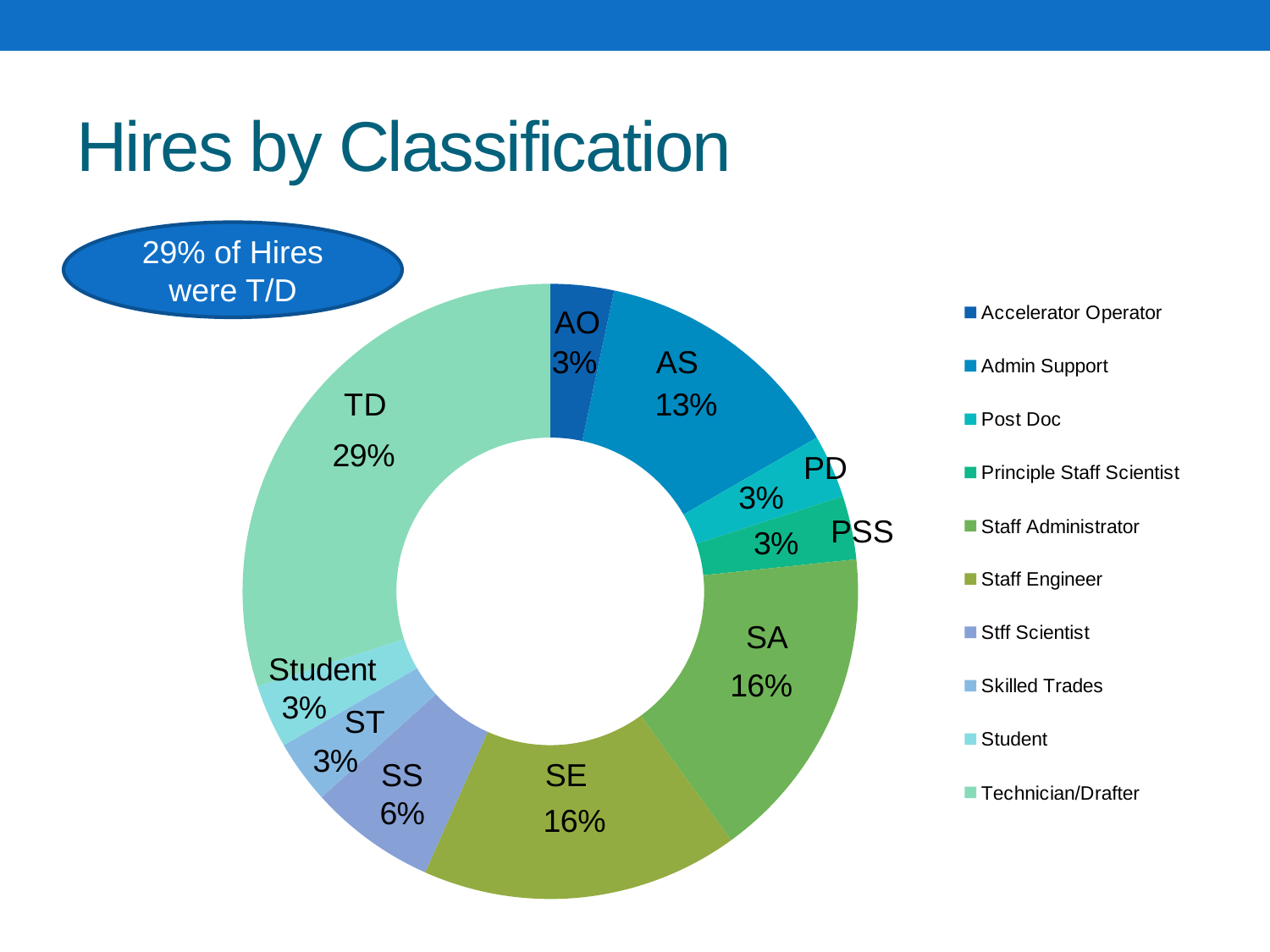
What kind of chart is shown on the slide? Pie (doughnut) chart What is the title of the chart? Hires by Classification What is the value of the SS slice? 6% Which classification has the largest share of hires? TD What percentage of hires does the TD slice represent? 29% Which is larger, the AS slice or the SS slice? AS What is the value shown for the SA slice? 16% How many entries does the legend list? 10 What is the difference in percentage points between the TD slice and the SA slice? 13 What percentage is shown for AS (Admin Support)? 13% What is the combined share of the SA and SE slices? 32% How many slices does the chart have? 10